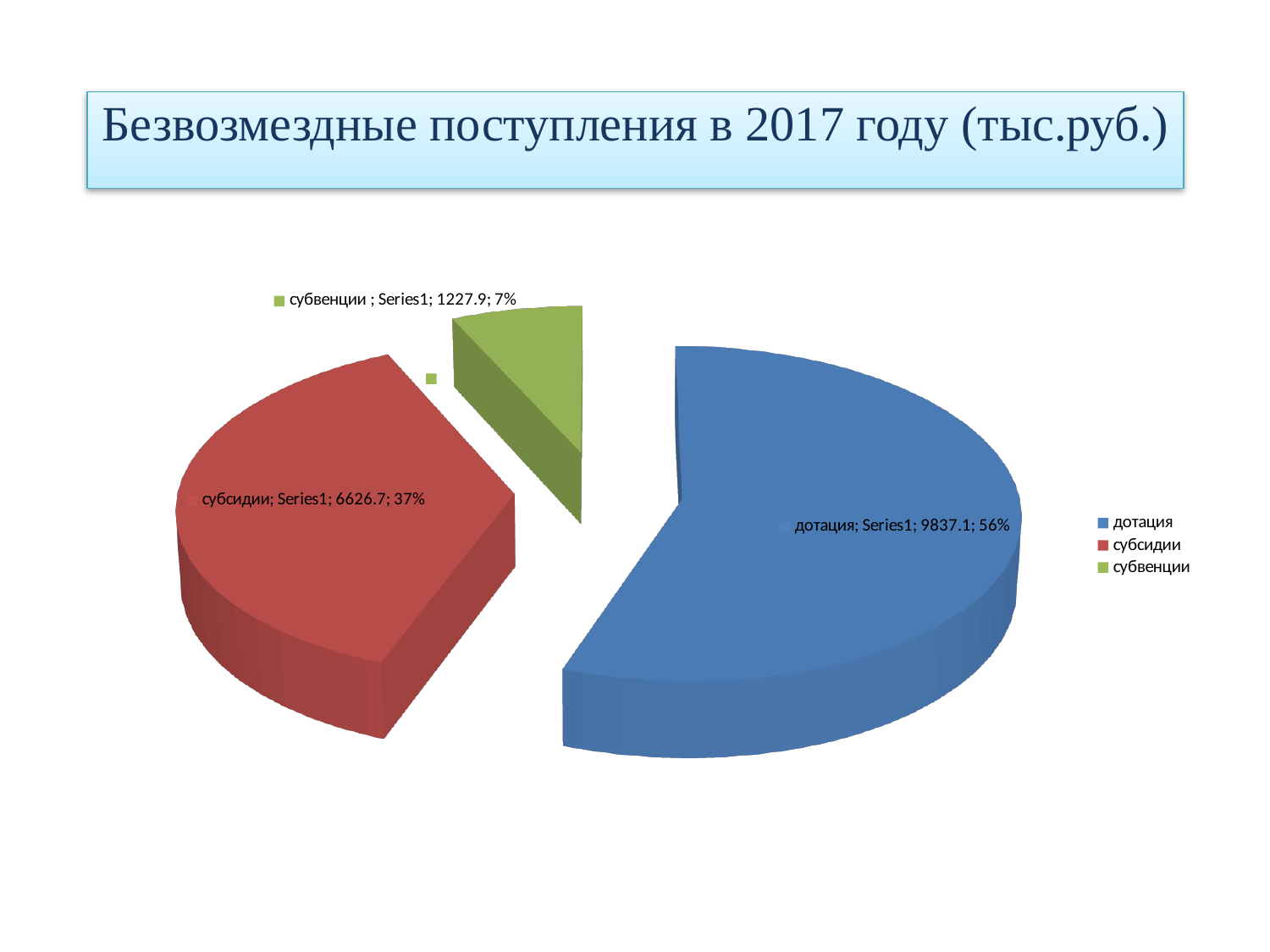
What share of the pie does субвенции represent? 7% What is the value for субвенции? 1227.9 What share of the pie does дотация represent? 56% Which is larger, субсидии or субвенции? субсидии What type of chart is shown on the slide? pie chart Which category has the largest slice? дотация What is the difference between the values for дотация and субсидии? 3210.4 How many categories does the pie chart have? 3 Which category has the smallest slice? субвенции What is the value for субсидии? 6626.7 What is the value for дотация? 9837.1 What is the title of the slide? Безвозмездные поступления в 2017 году (тыс.руб.)